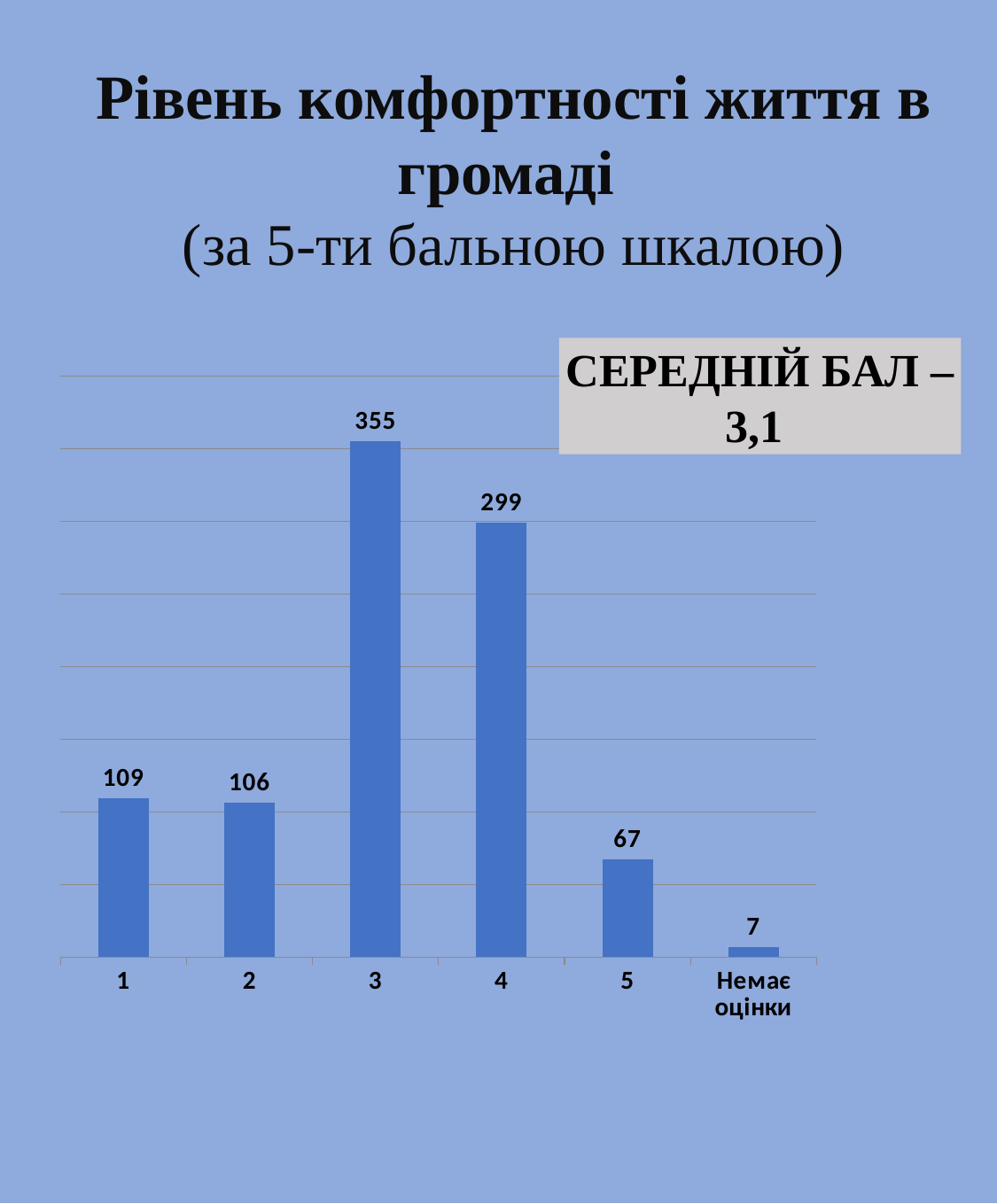
What is the difference between the values for rating 3 and rating 4? 56 What is the value for the "Немає оцінки" category? 7 What is the total of the values for ratings 1 through 5? 936 What kind of chart is shown on the slide? bar chart What is the value for rating 5? 67 Which category has the highest value? 3 What is the difference between the values for rating 1 and rating 2? 3 Which category has the lowest value? Немає оцінки Which is larger, the value for rating 4 or the value for rating 5? 4 How many categories are shown on the x axis? 6 What average score (середній бал) is stated on the slide? 3,1 What is the value for rating 3? 355